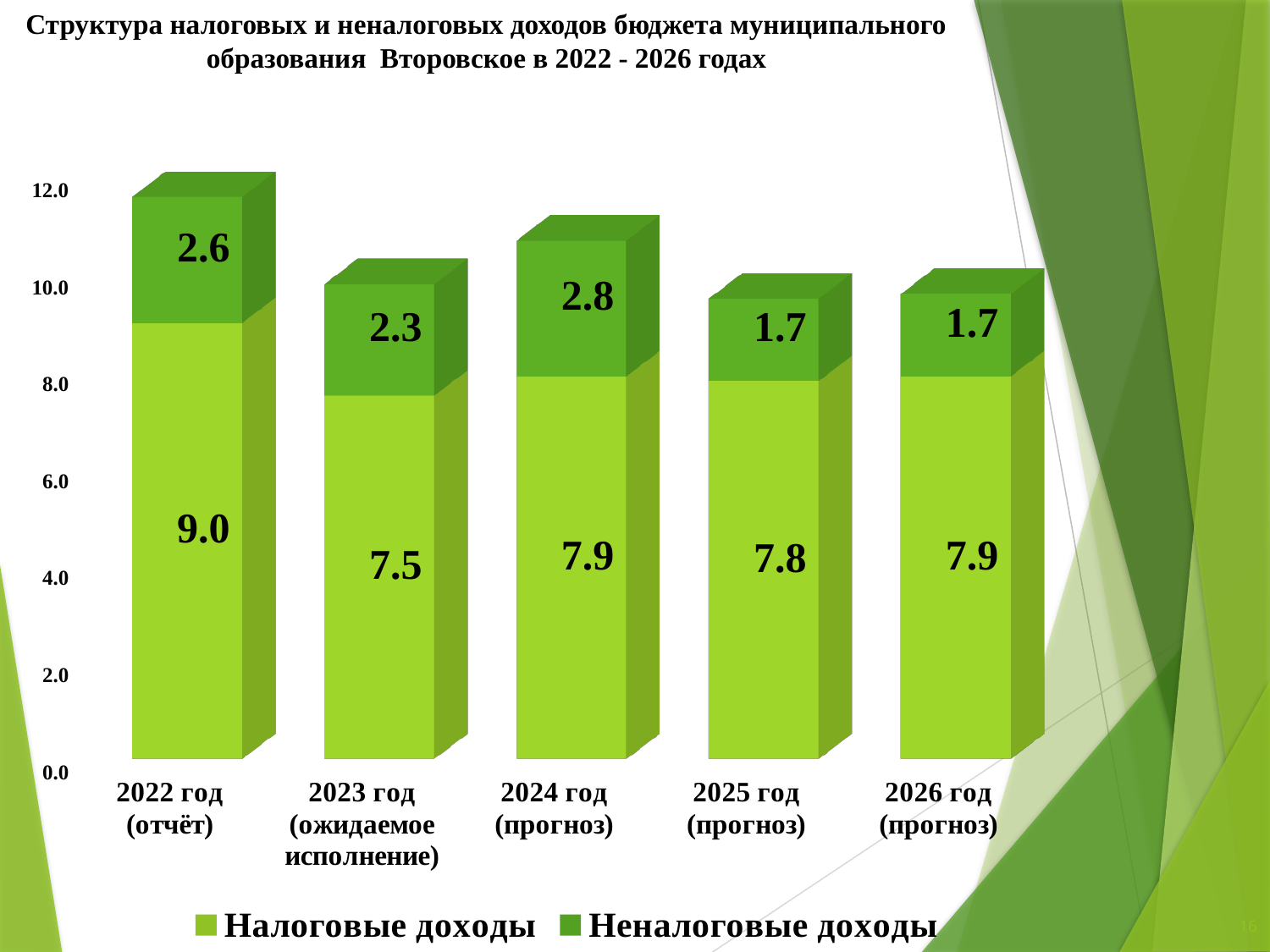
Which year has the lowest value of Налоговые доходы? 2023 год (ожидаемое исполнение) What is the value of Налоговые доходы for 2023 год (ожидаемое исполнение)? 7.5 What is the value of Налоговые доходы for 2022 год (отчёт)? 9.0 What is the value of Неналоговые доходы for 2024 год (прогноз)? 2.8 How many years (categories) are shown on the x axis? 5 Which is larger: Неналоговые доходы in 2024 год (прогноз) or in 2025 год (прогноз)? 2024 год (прогноз) What is the total of the stacked bar for 2025 год (прогноз)? 9.5 How many series does the legend list? 2 Which year has the highest value of Налоговые доходы? 2022 год (отчёт) What is the difference between Налоговые доходы in 2022 год (отчёт) and 2023 год (ожидаемое исполнение)? 1.5 What kind of chart is shown on the slide? Stacked bar chart What is the total of the stacked bar for 2022 год (отчёт)? 11.6